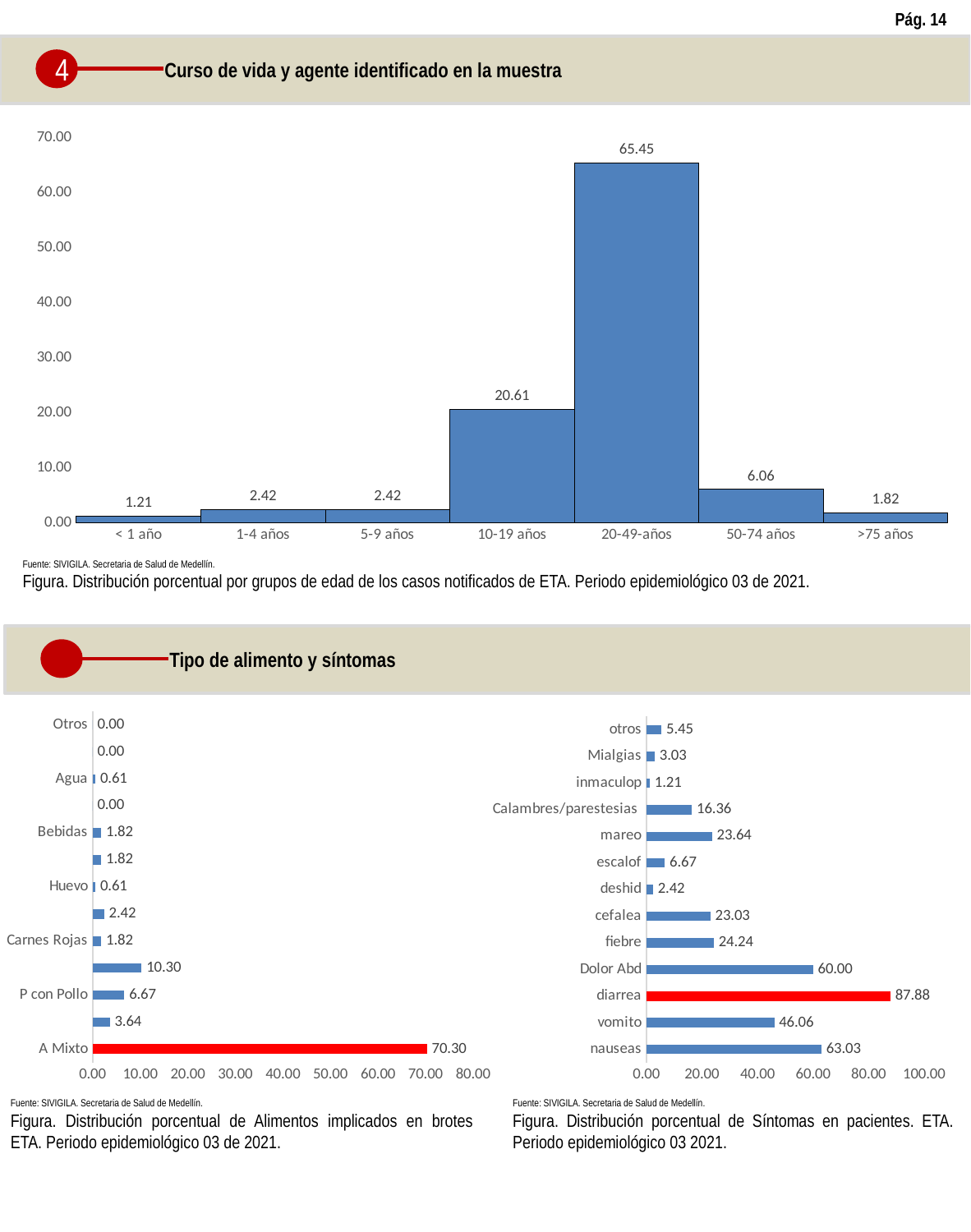
In the bottom-right chart (síntomas), what is the difference between the values for nauseas and vomito? 16.97 In the bottom-right chart (síntomas), which symptom has the lowest value? inmaculop In the top chart (age groups), which age group has the lowest value? < 1 año In the top chart (age groups), how many age groups are shown on the x axis? 7 In the bottom-right chart (síntomas), how many symptoms are listed? 13 What kind of chart is the top chart (age groups)? bar chart In the top chart (age groups), what is the difference between the values for 20-49-años and 10-19 años? 44.84 In the top chart (age groups), which age group has the highest value? 20-49-años In the bottom-left chart (alimentos), what is the value for A Mixto? 70.30 In the bottom-left chart (alimentos), which is larger, P con Pollo or Carnes Rojas? P con Pollo In the bottom-right chart (síntomas), what is the value for diarrea? 87.88 In the top chart (age groups), what is the value for 20-49-años? 65.45